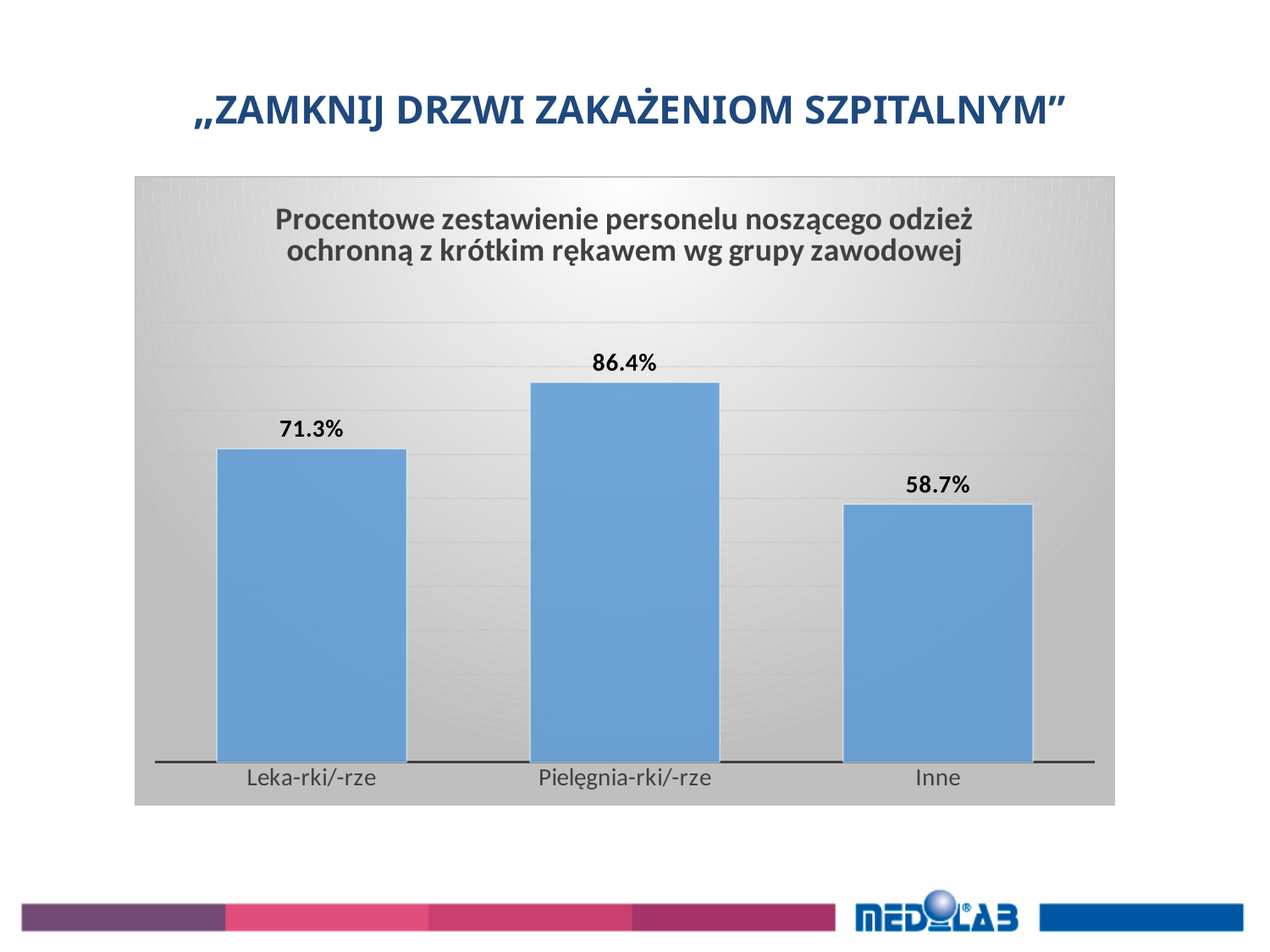
Which category has the lowest value? Inne What is the value for Pielęgnia-rki/-rze? 86.4% Which category has the highest value? Pielęgnia-rki/-rze What is the value for Inne? 58.7% What is the title of the chart? Procentowe zestawienie personelu noszącego odzież ochronną z krótkim rękawem wg grupy zawodowej Which is larger, the value for Leka-rki/-rze or the value for Inne? Leka-rki/-rze What is the difference between the values for Leka-rki/-rze and Inne? 12.6% What colour are the bars in the chart? Blue What is the difference between the values for Pielęgnia-rki/-rze and Leka-rki/-rze? 15.1% What kind of chart is shown on the slide? Bar chart What is the value for Leka-rki/-rze? 71.3% How many categories are shown on the chart? 3